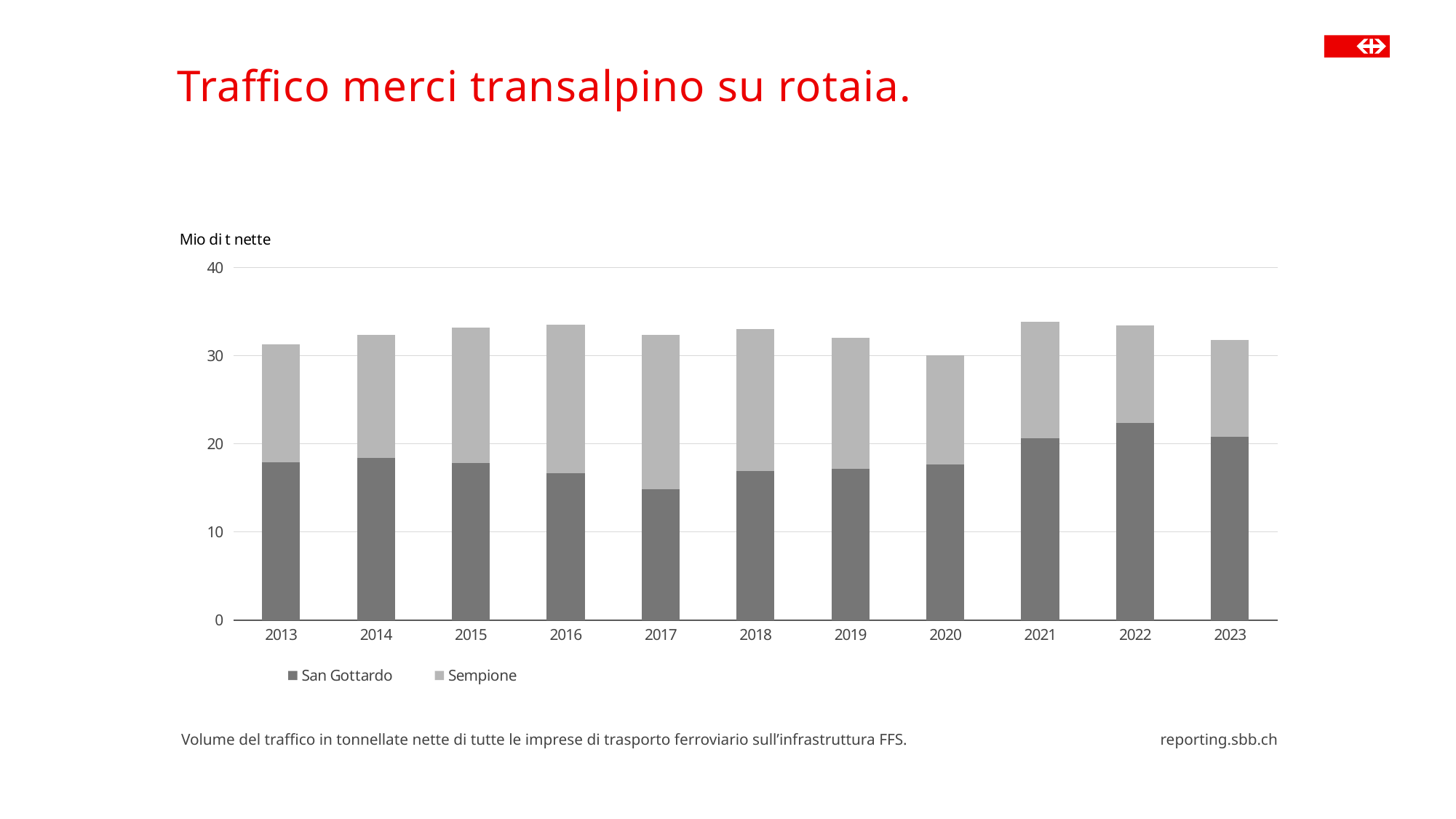
Which two series are listed in the chart legend? San Gottardo and Sempione How many years are shown on the x axis of the chart? 11 Is the San Gottardo value for 2017 greater or less than 20? less Which is larger, the Sempione value for 2017 or the Sempione value for 2022? 2017 In which year is the San Gottardo value the lowest? 2017 In which year is the San Gottardo value the highest? 2022 Is the total stacked bar for 2021 greater or less than 30? greater What kind of chart is shown on the slide? stacked bar chart What unit is indicated above the y axis of the chart? Mio di t nette Is the San Gottardo value for 2022 greater or less than 20? greater Which year has the lowest total stacked bar? 2020 How many series does the legend list? 2